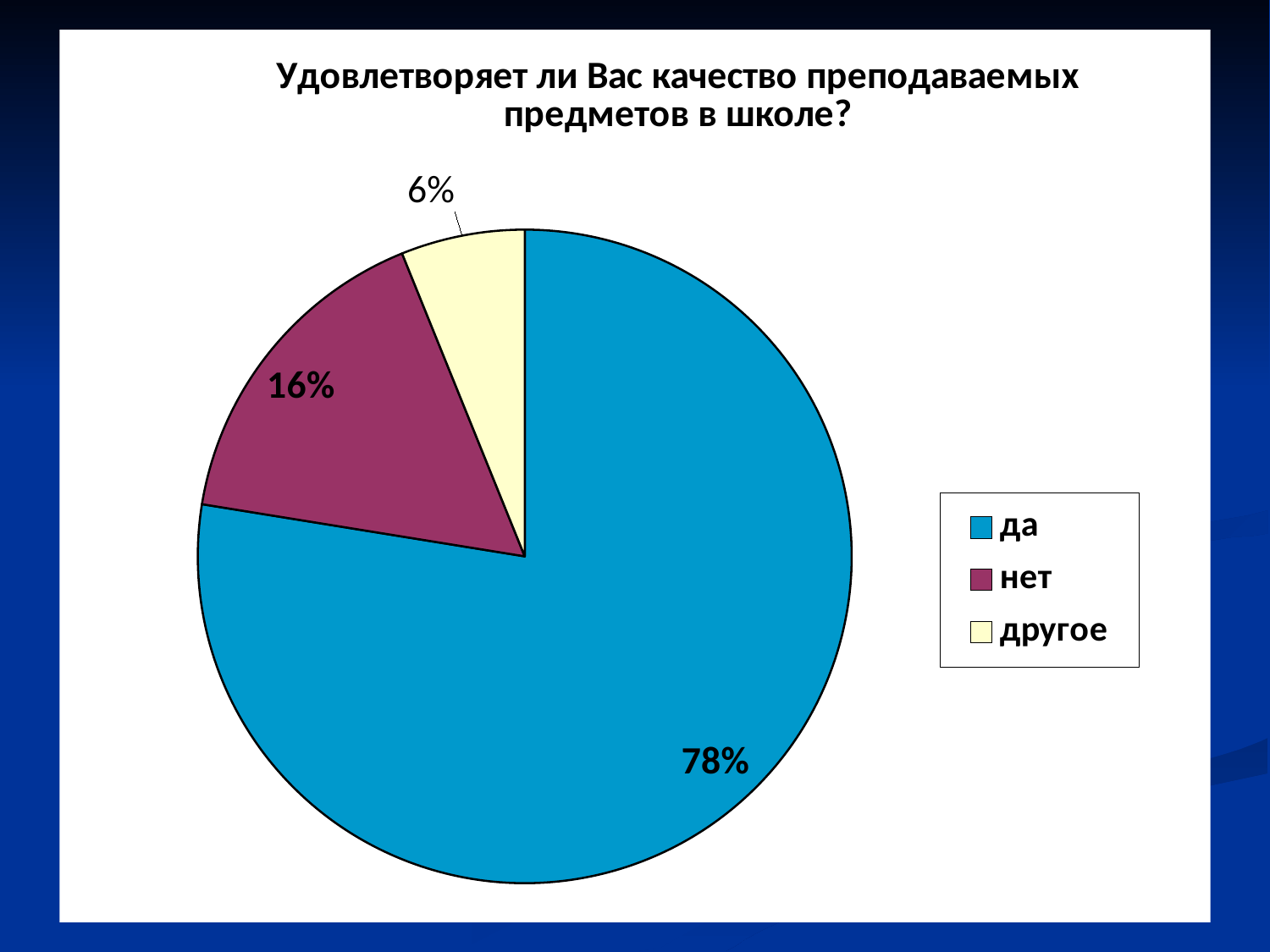
How many categories does the pie chart show? 3 What is the title of the chart? Удовлетворяет ли Вас качество преподаваемых предметов в школе? What is the value shown for "нет"? 16% What is the value shown for "другое"? 6% What is the difference between the "да" and "нет" shares? 62% What is the difference between the "нет" and "другое" shares? 10% Which category has the smallest slice of the pie? другое Which colour represents the "нет" category in the legend? purple Which category has the largest slice of the pie? да Which is larger, the share for "нет" or the share for "другое"? нет What kind of chart is shown on the slide? pie chart What share of the pie does the "да" slice represent? 78%